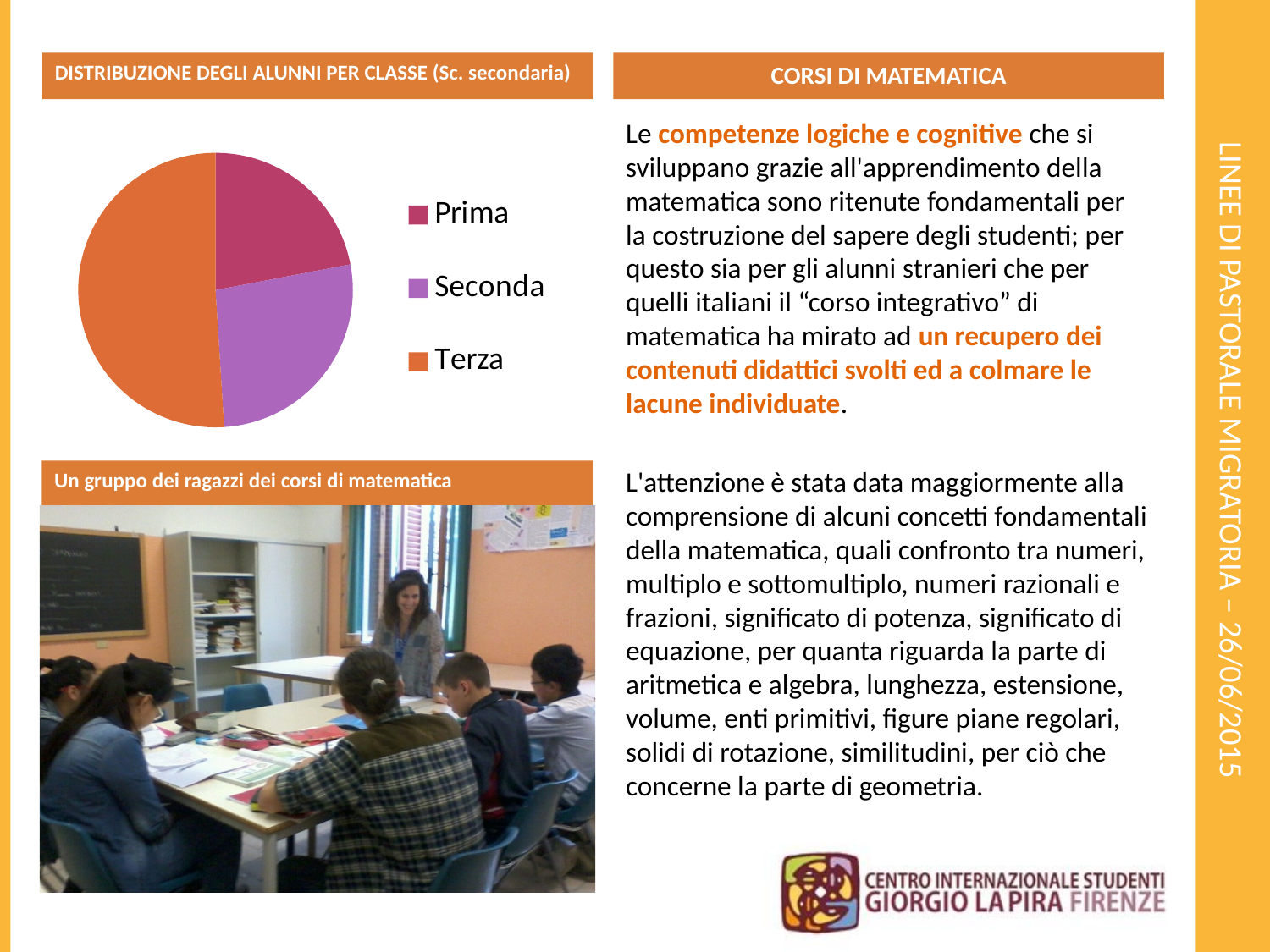
What kind of chart is shown under the title "DISTRIBUZIONE DEGLI ALUNNI PER CLASSE (Sc. secondaria)"? pie chart What is the title of the pie chart? DISTRIBUZIONE DEGLI ALUNNI PER CLASSE (Sc. secondaria) How many slices does the pie chart have? 3 Which class has the largest slice in the pie chart? Terza In the pie chart, which slice is larger, Seconda or Terza? Terza Which class has the smallest slice in the pie chart? Prima How many entries does the legend of the pie chart list? 3 In the pie chart, which slice is larger, Terza or Prima? Terza What colour is the Terza slice in the pie chart? orange